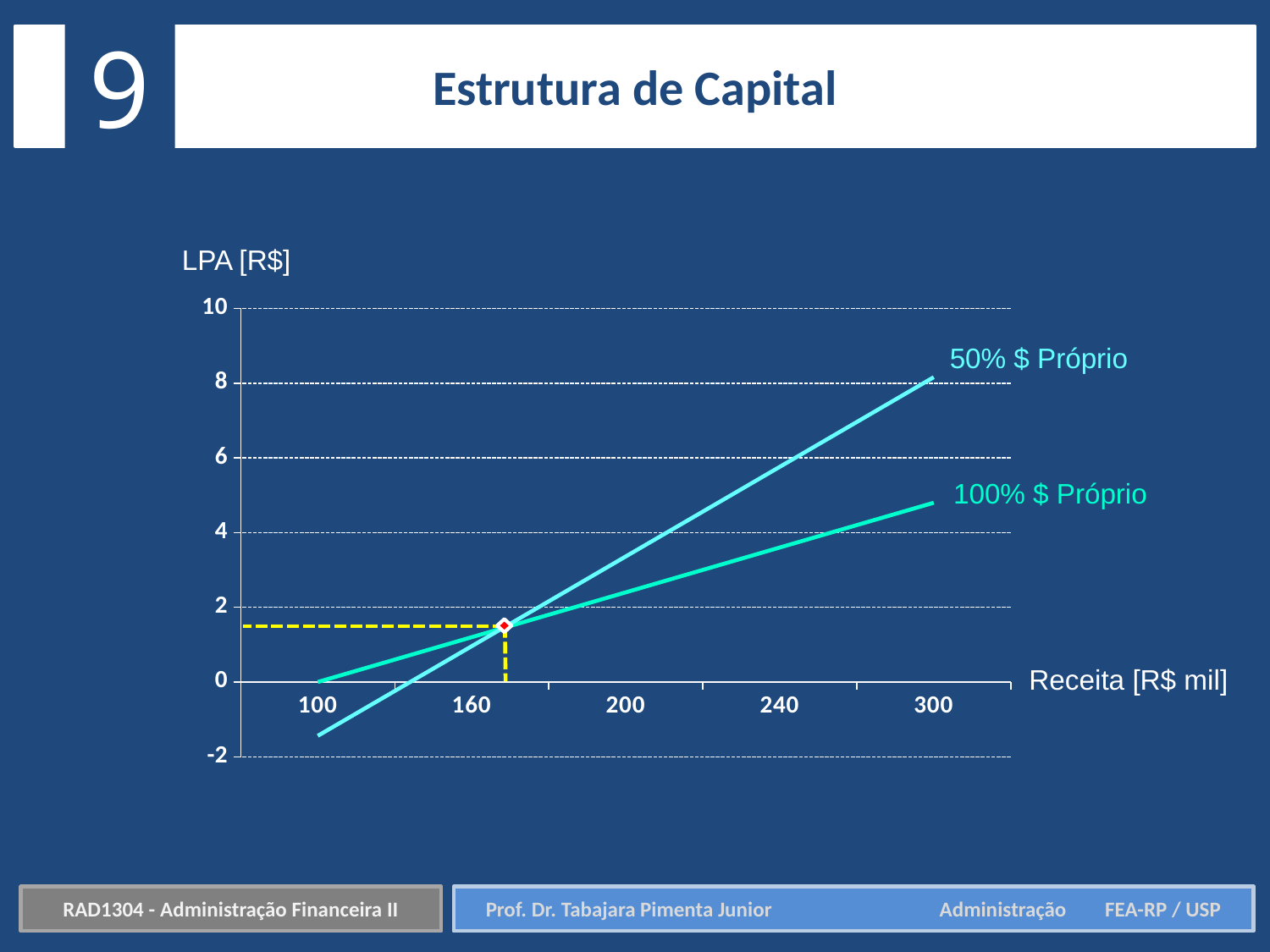
At a Receita of 300, is the LPA value for the 50% $ Próprio line greater or less than 6? greater What kind of chart is shown on the slide? line chart What is the LPA value of the 100% $ Próprio line at a Receita of 100? 0 What is the label of the horizontal axis of the chart? Receita [R$ mil] How many tick labels are shown on the Receita axis? 5 At a Receita of 100, which line has the higher LPA value, 50% $ Próprio or 100% $ Próprio? 100% $ Próprio How many lines are plotted on the chart? 2 Do the LPA values of the 50% $ Próprio line rise or fall as Receita increases? rise At a Receita of 300, is the LPA value for the 100% $ Próprio line greater or less than 6? less What is the title of the slide containing the chart? Estrutura de Capital At a Receita of 300, which line has the higher LPA value, 50% $ Próprio or 100% $ Próprio? 50% $ Próprio At a Receita of 100, is the LPA value for the 50% $ Próprio line greater or less than 0? less